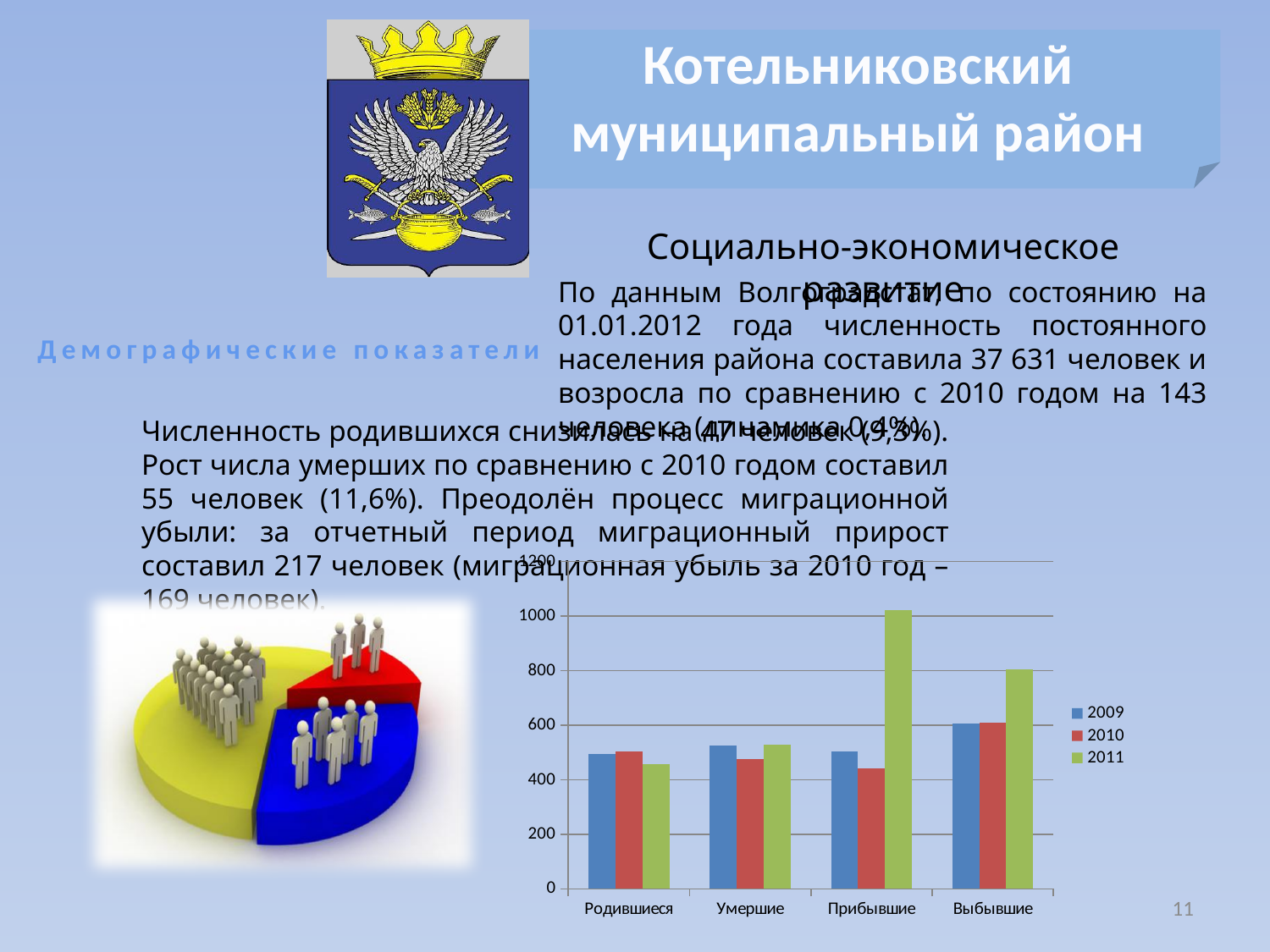
In the bar chart, which series is shown in green? 2011 In the bar chart, which category has the tallest bar overall? Прибывшие How many series does the legend of the bar chart list? 3 How many categories are shown on the x axis of the bar chart? 4 Which years are listed in the legend of the bar chart? 2009, 2010, 2011 In the bar chart, which is larger for Прибывшие: the 2010 value or the 2011 value? 2011 In the bar chart, which is larger for Родившиеся: the 2009 value or the 2011 value? 2009 In the bar chart, is the 2009 value for Выбывшие greater or less than 400? greater In the bar chart, is the 2010 value for Прибывшие greater or less than 600? less What kind of chart is shown at the bottom right of the slide? bar chart In the bar chart, is the 2011 value for Прибывшие greater or less than 1000? greater